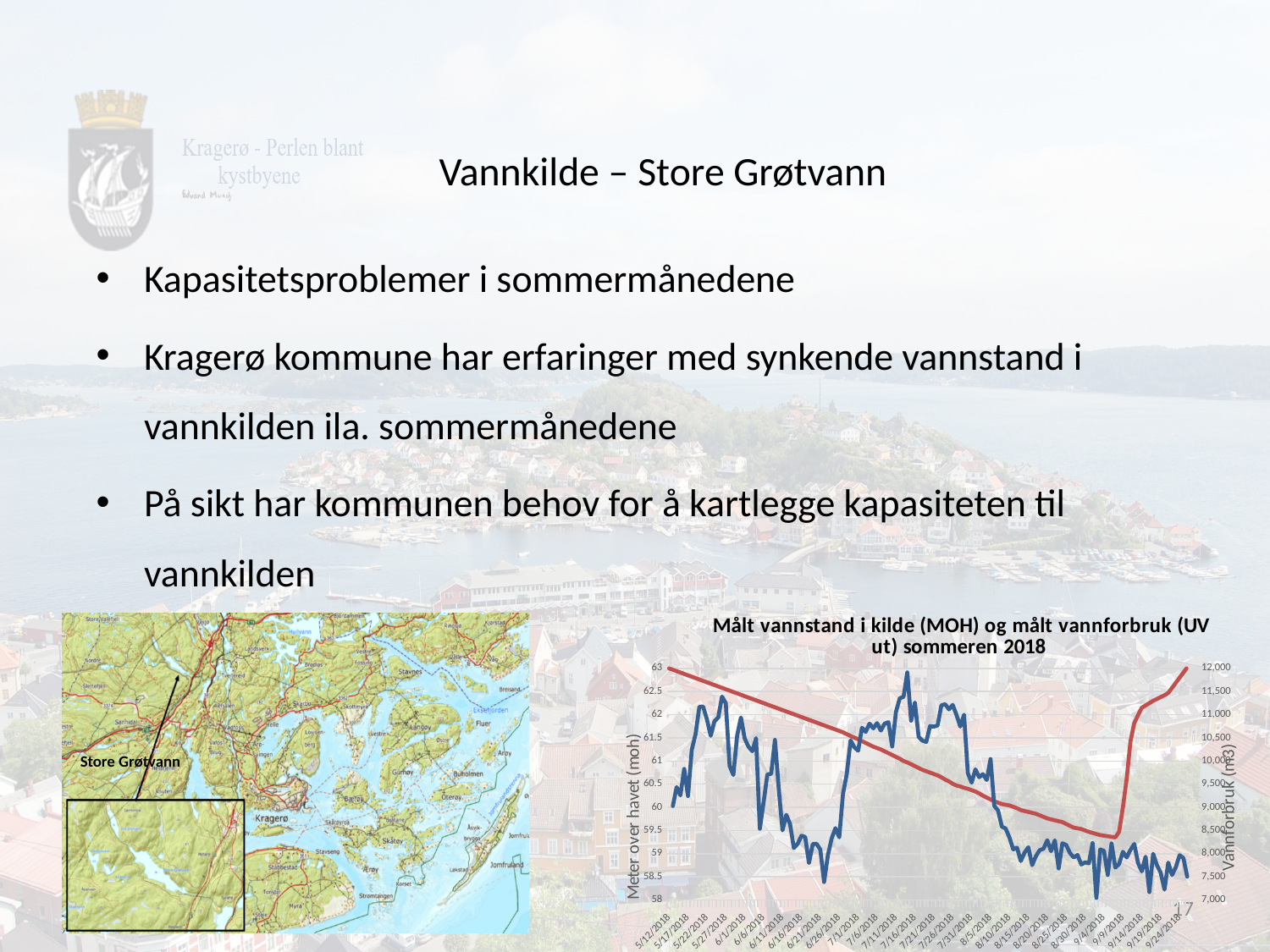
What is the highest tick value on the right axis of the chart? 12,000 On the left axis, is the red line at 8/25/2018 greater or less than 60? less Does the red line rise or fall between 9/9/2018 and 9/24/2018? rise What is the first date shown on the x axis of the chart? 5/12/2018 On the left axis, is the red line at 6/1/2018 greater or less than 61.5? greater Does the red line rise or fall between 5/12/2018 and 8/30/2018? fall How many lines are plotted on the chart? 2 What is the last date shown on the x axis of the chart? 9/24/2018 What kind of chart is shown at the bottom right of the slide? line chart What is the label of the left vertical axis of the chart? Meter over havet (moh) What is the highest tick value on the left axis of the chart? 63 What is the title of the chart on the slide? Målt vannstand i kilde (MOH) og målt vannforbruk (UV ut) sommeren 2018